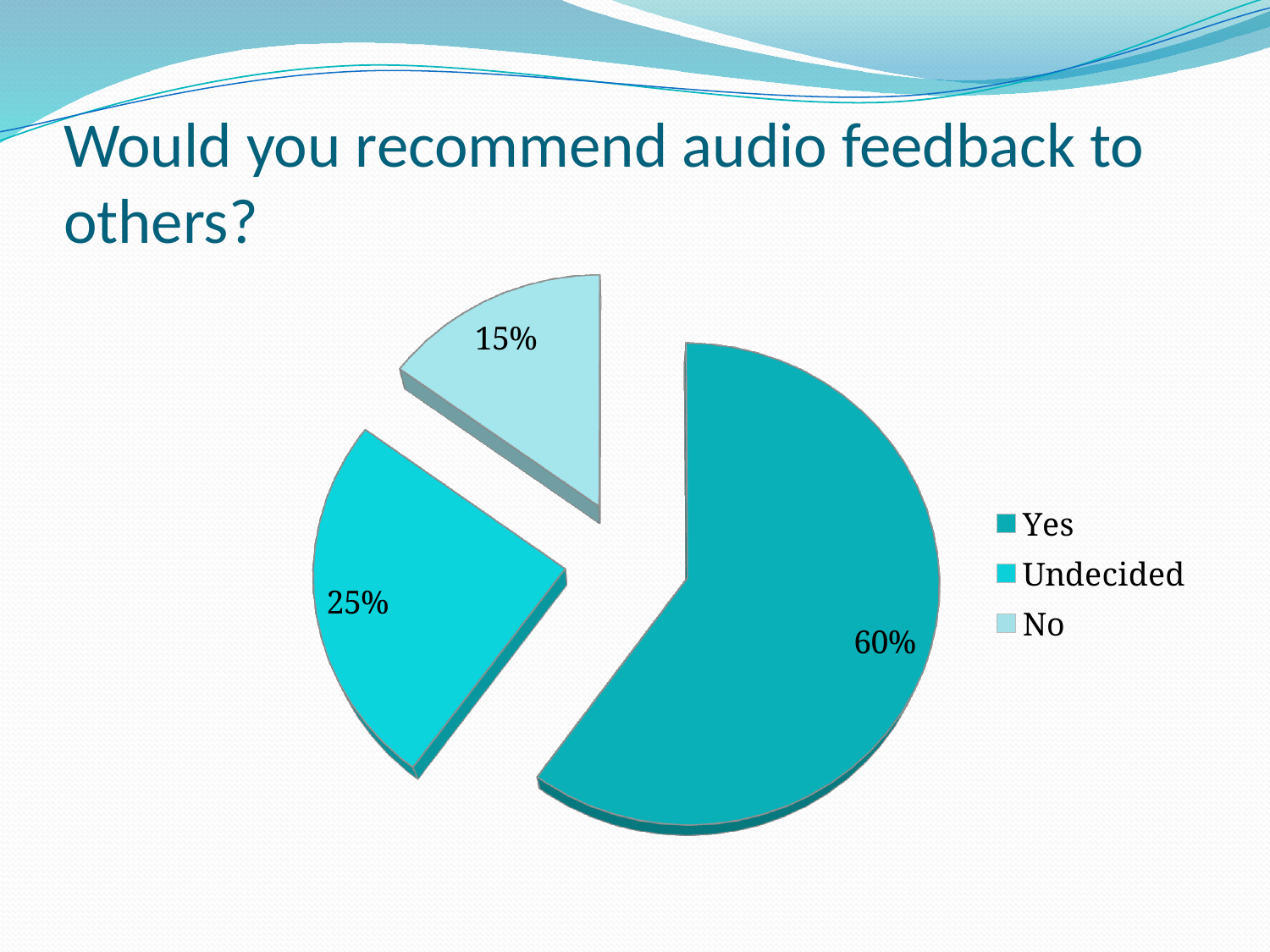
What kind of chart is shown on the slide? Pie chart What percentage of respondents were Undecided? 25% Which response has the smallest share of the pie? No What is the title of the slide containing the chart? Would you recommend audio feedback to others? How many slices does the pie chart have? 3 What is the difference in percentage points between Undecided and No? 10 What percentage of respondents answered No? 15% Which legend entry is listed last? No Which response has the largest share of the pie? Yes Which is larger, the share for Undecided or the share for No? Undecided What is the difference in percentage points between Yes and Undecided? 35 What percentage of respondents answered Yes? 60%